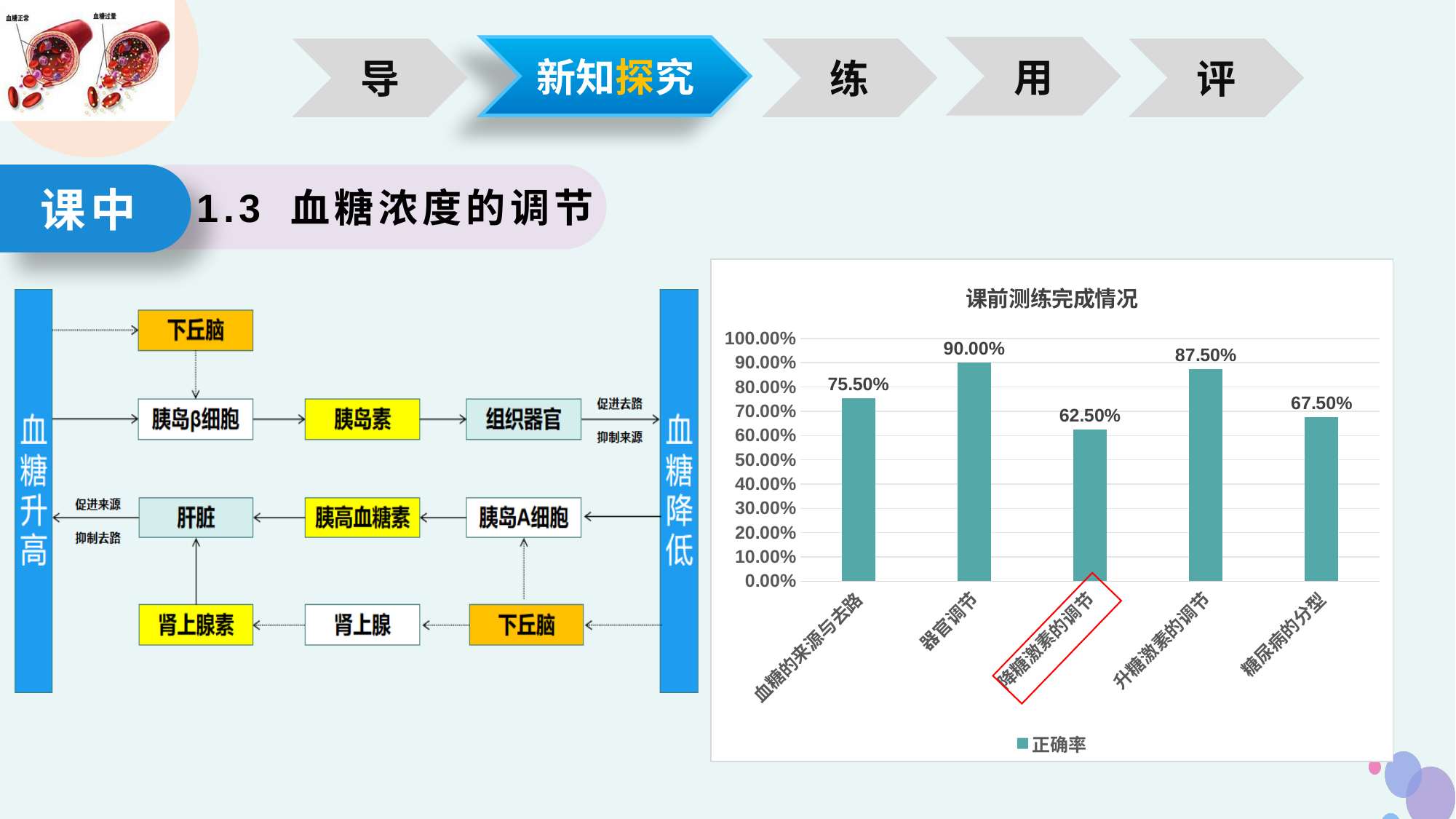
What is the value for 糖尿病的分型 in the chart? 67.50% What is the title of the chart? 课前测练完成情况 What is the difference between the values for 器官调节 and 降糖激素的调节? 27.50% Which category has the highest value in the chart? 器官调节 What is the value for 血糖的来源与去路 in the chart? 75.50% Which is larger, the value for 血糖的来源与去路 or the value for 糖尿病的分型? 血糖的来源与去路 How many categories are shown in the chart? 5 What is the value for 升糖激素的调节 in the chart? 87.50% What is the value for 降糖激素的调节 in the chart? 62.50% What is the value for 器官调节 in the chart? 90.00% What type of chart is shown on the slide? Bar chart Which category has the lowest value in the chart? 降糖激素的调节